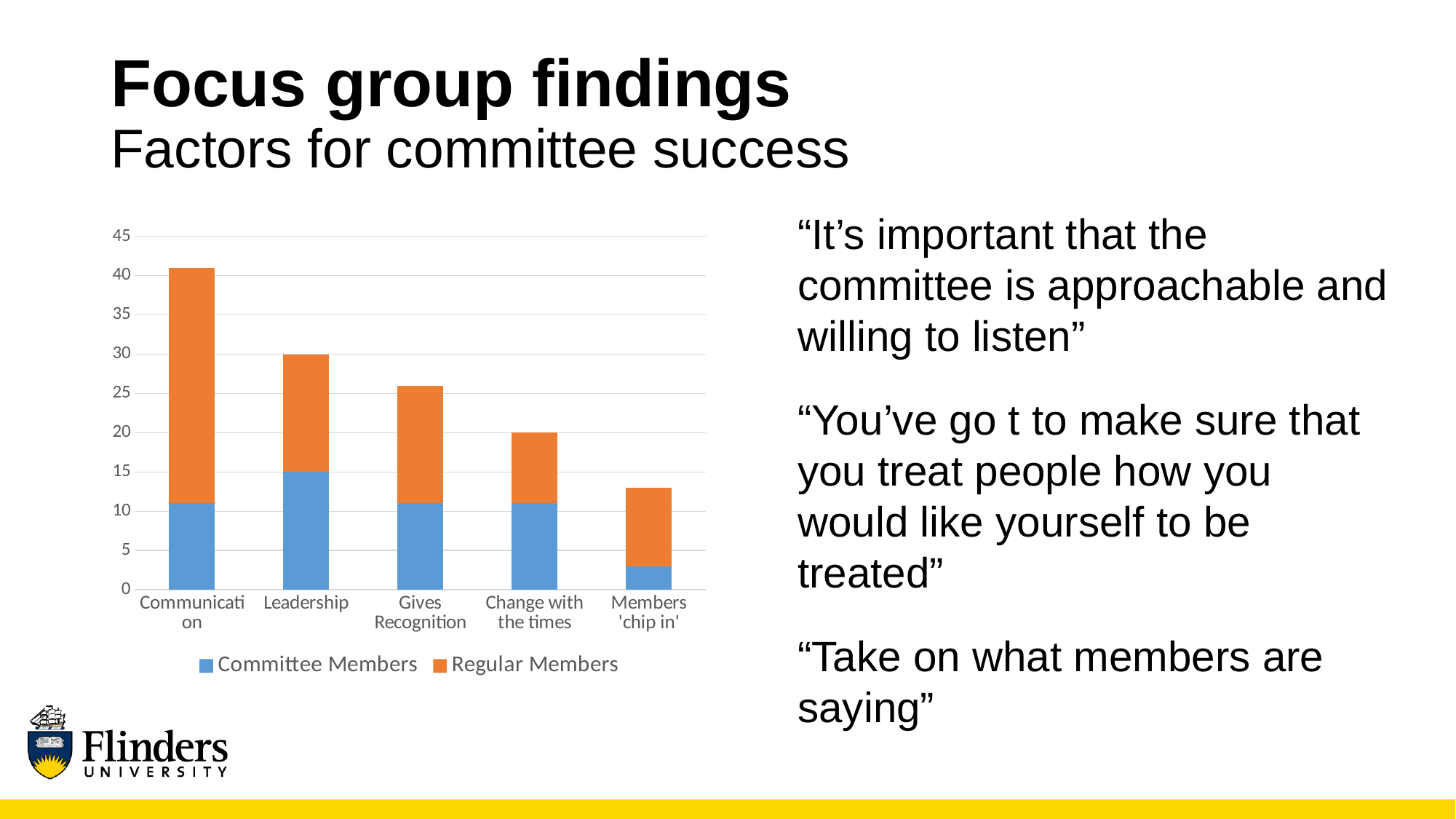
Which category has the shortest stacked bar overall? Members 'chip in' How many series does the chart legend list? 2 What is the Committee Members value for Leadership? 15 Do the total bar heights rise or fall from left to right across the categories? fall What is the total height of the stacked bar for Leadership? 30 Which category has the highest value for Committee Members? Leadership Which category has the tallest stacked bar overall? Communication How many categories are shown on the x axis of the chart? 5 Is the total for Communication greater or less than 35? greater Is the total for Members 'chip in' greater or less than 15? less What is the total height of the stacked bar for Change with the times? 20 What kind of chart is shown on the slide? Stacked bar chart